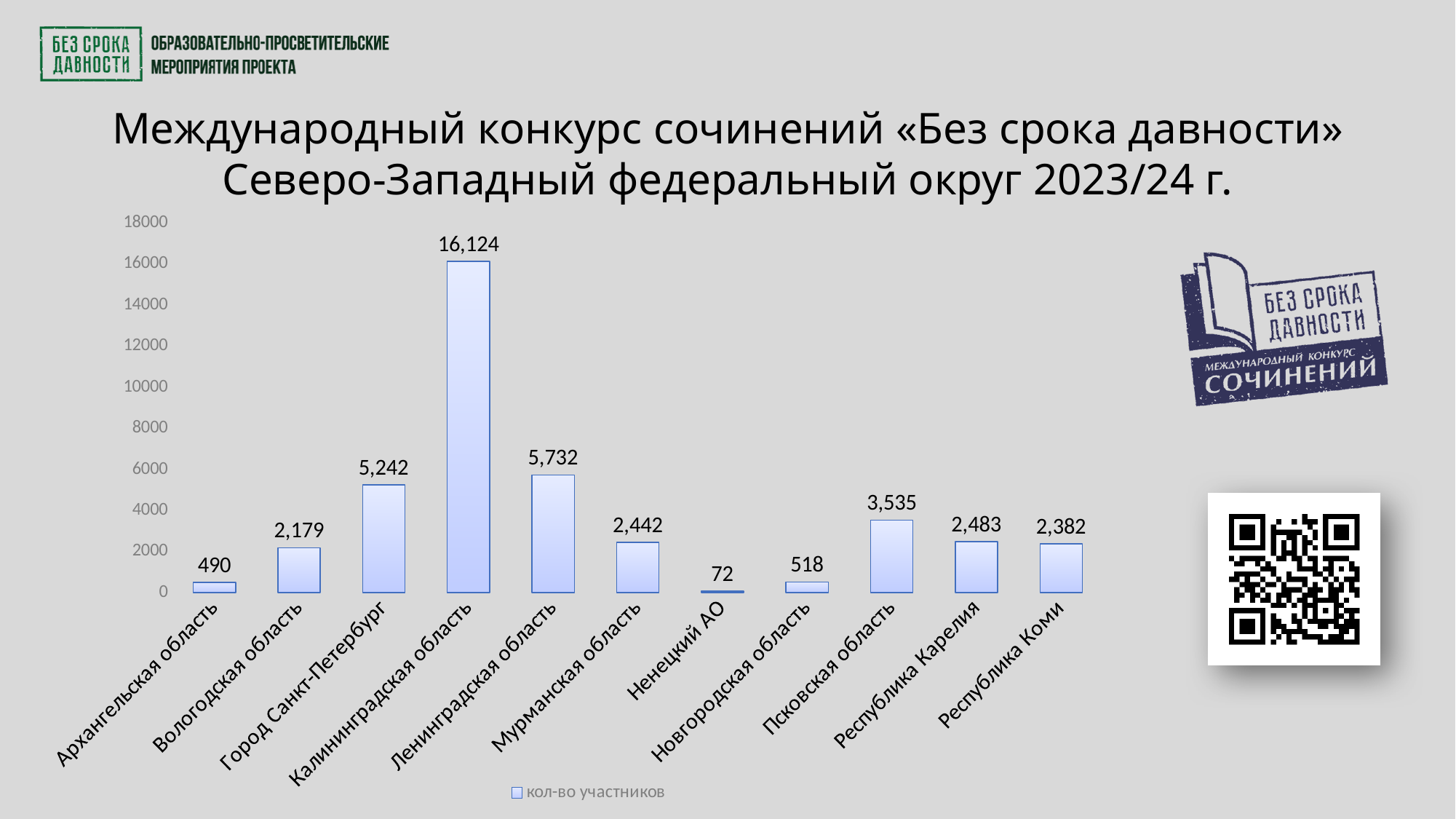
What is the difference between the values for Республика Карелия and Республика Коми? 101 Which category has the lowest value? Ненецкий АО Which is larger, the value for Ленинградская область or the value for Город Санкт-Петербург? Ленинградская область Is the value for Псковская область greater or less than 4000? less What is the difference between the values for Калининградская область and Ленинградская область? 10,392 What is the value for Ненецкий АО? 72 What is the value for Калининградская область? 16,124 What is the value for Псковская область? 3,535 What kind of chart is shown on the slide? bar chart Which category has the highest value? Калининградская область How many categories are shown on the x axis? 11 How many series does the legend list? 1